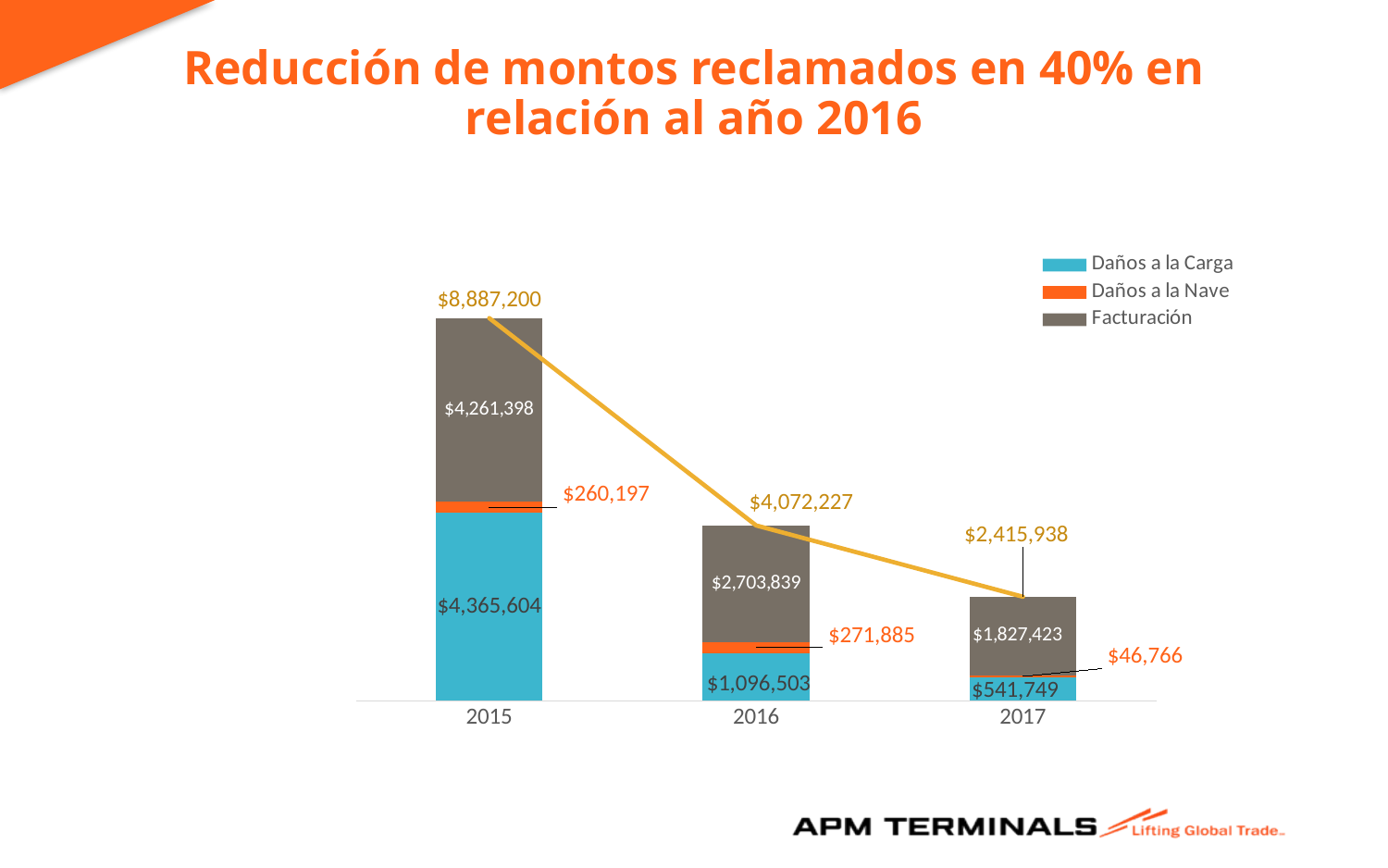
How many years are shown on the x axis? 3 Which is larger, Daños a la Nave in 2015 or Daños a la Nave in 2016? 2016 What is the value of Daños a la Carga for 2015? $4,365,604 What is the value of Daños a la Nave for 2017? $46,766 What kind of chart is shown on the slide? Stacked bar chart with a line What is the value of Facturación for 2016? $2,703,839 What is the difference between the Facturación values for 2016 and 2017? $876,416 How many series does the legend list? 3 Do the total amounts rise or fall from 2015 to 2017? Fall Which year has the highest total amount? 2015 Which year has the lowest value for Daños a la Carga? 2017 What is the total shown for the 2016 bar? $4,072,227